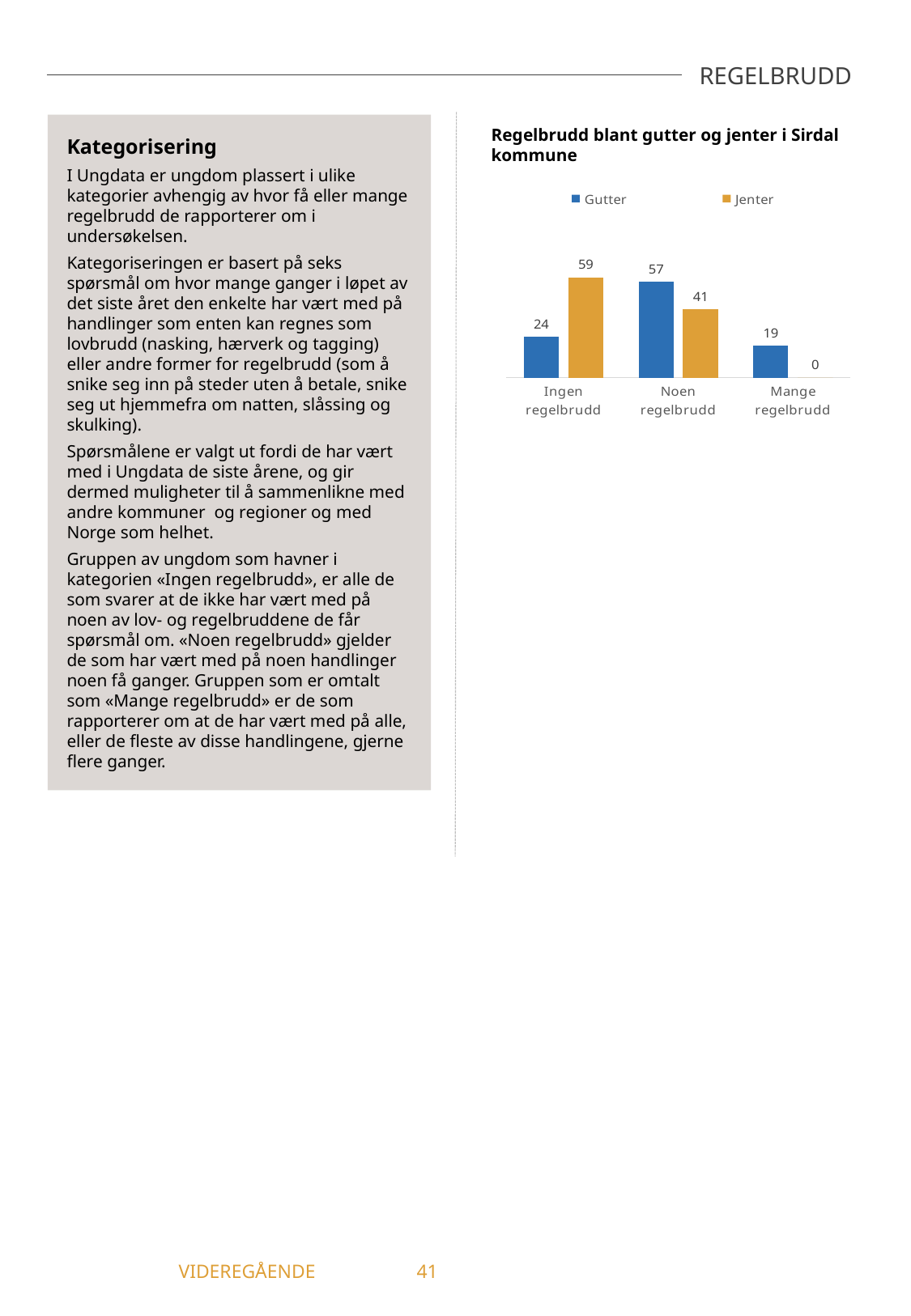
What is the value for Jenter in the Noen regelbrudd category? 41 How many series does the legend list? 2 What is the difference between the Jenter and Gutter values in the Ingen regelbrudd category? 35 What is the difference between the Gutter and Jenter values in the Noen regelbrudd category? 16 Which category has the highest value for Jenter? Ingen regelbrudd What is the value for Gutter in the Ingen regelbrudd category? 24 What is the value for Jenter in the Mange regelbrudd category? 0 What kind of chart is shown? Bar chart What is the title of the chart? Regelbrudd blant gutter og jenter i Sirdal kommune Which is larger in the Mange regelbrudd category, Gutter or Jenter? Gutter How many categories are shown on the x axis? 3 Which category has the lowest value for Gutter? Mange regelbrudd